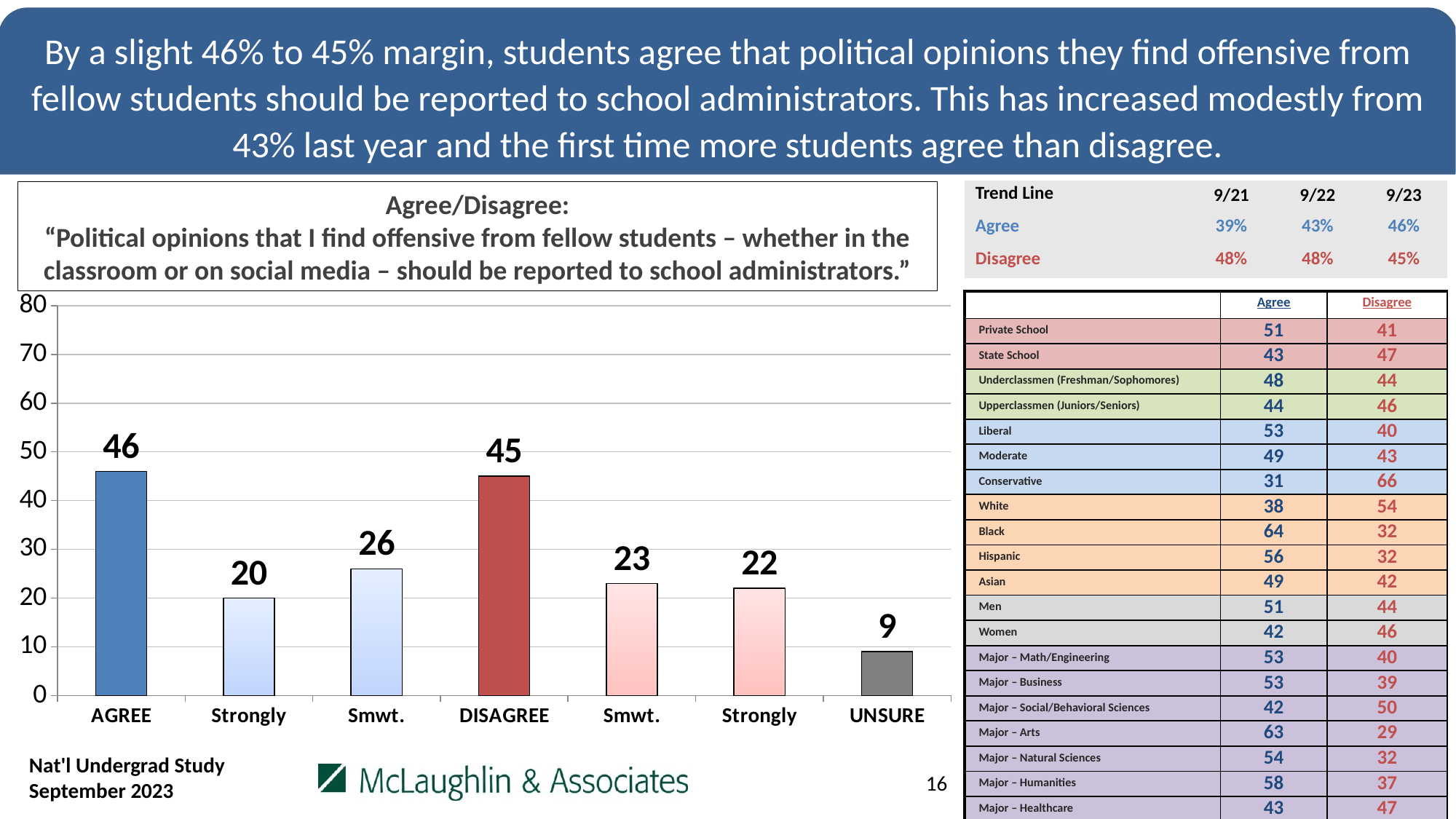
What type of chart is shown on the slide? bar chart What is the value of the Smwt. bar under AGREE (the bar immediately to the left of DISAGREE)? 26 Which bar has the lowest value? UNSURE Which is larger, the Smwt. bar on the disagree side or the Strongly bar on the disagree side? Smwt. What is the value of the AGREE bar? 46 Which bar has the highest value? AGREE How many bars are shown in the chart? 7 Is the value of the UNSURE bar greater or less than 10? less What is the value of the DISAGREE bar? 45 What is the difference between the AGREE bar and the DISAGREE bar? 1 What is the value of the UNSURE bar? 9 What is the difference between the Smwt. agree bar (26) and the Strongly agree bar (20)? 6